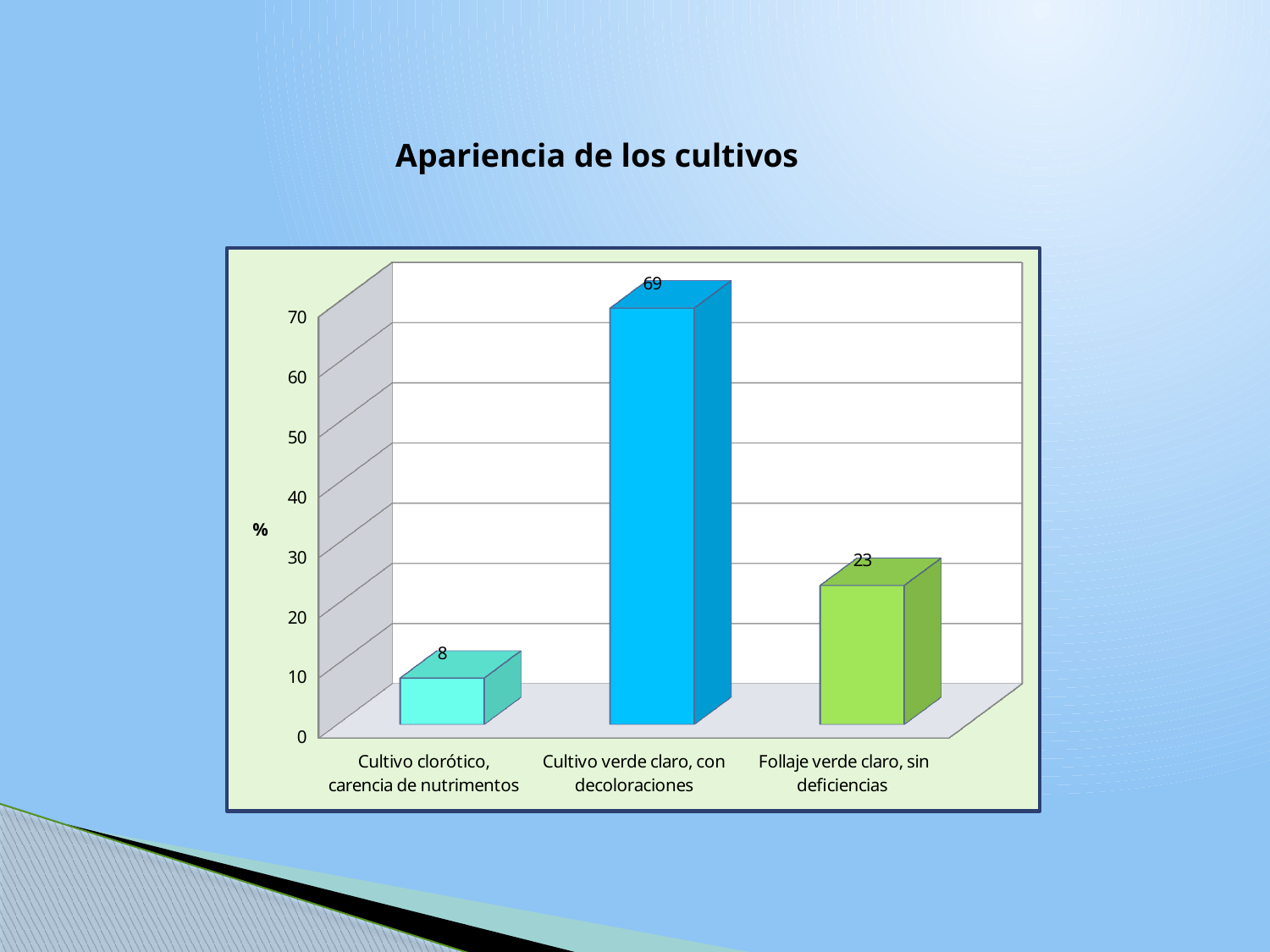
What is the value for "Follaje verde claro, sin deficiencias"? 23 What is the difference between the values for "Cultivo verde claro, con decoloraciones" and "Follaje verde claro, sin deficiencias"? 46 What is the value for "Cultivo verde claro, con decoloraciones"? 69 What kind of chart is shown on the slide? bar chart Which category has the highest value? Cultivo verde claro, con decoloraciones How many categories are shown on the chart? 3 What is the difference between the values for "Follaje verde claro, sin deficiencias" and "Cultivo clorótico, carencia de nutrimentos"? 15 Is the value for "Cultivo verde claro, con decoloraciones" greater or less than 60? greater Which category has the lowest value? Cultivo clorótico, carencia de nutrimentos Which is larger: the value for "Follaje verde claro, sin deficiencias" or for "Cultivo clorótico, carencia de nutrimentos"? Follaje verde claro, sin deficiencias What is the value for "Cultivo clorótico, carencia de nutrimentos"? 8 What is the title of the chart? Apariencia de los cultivos